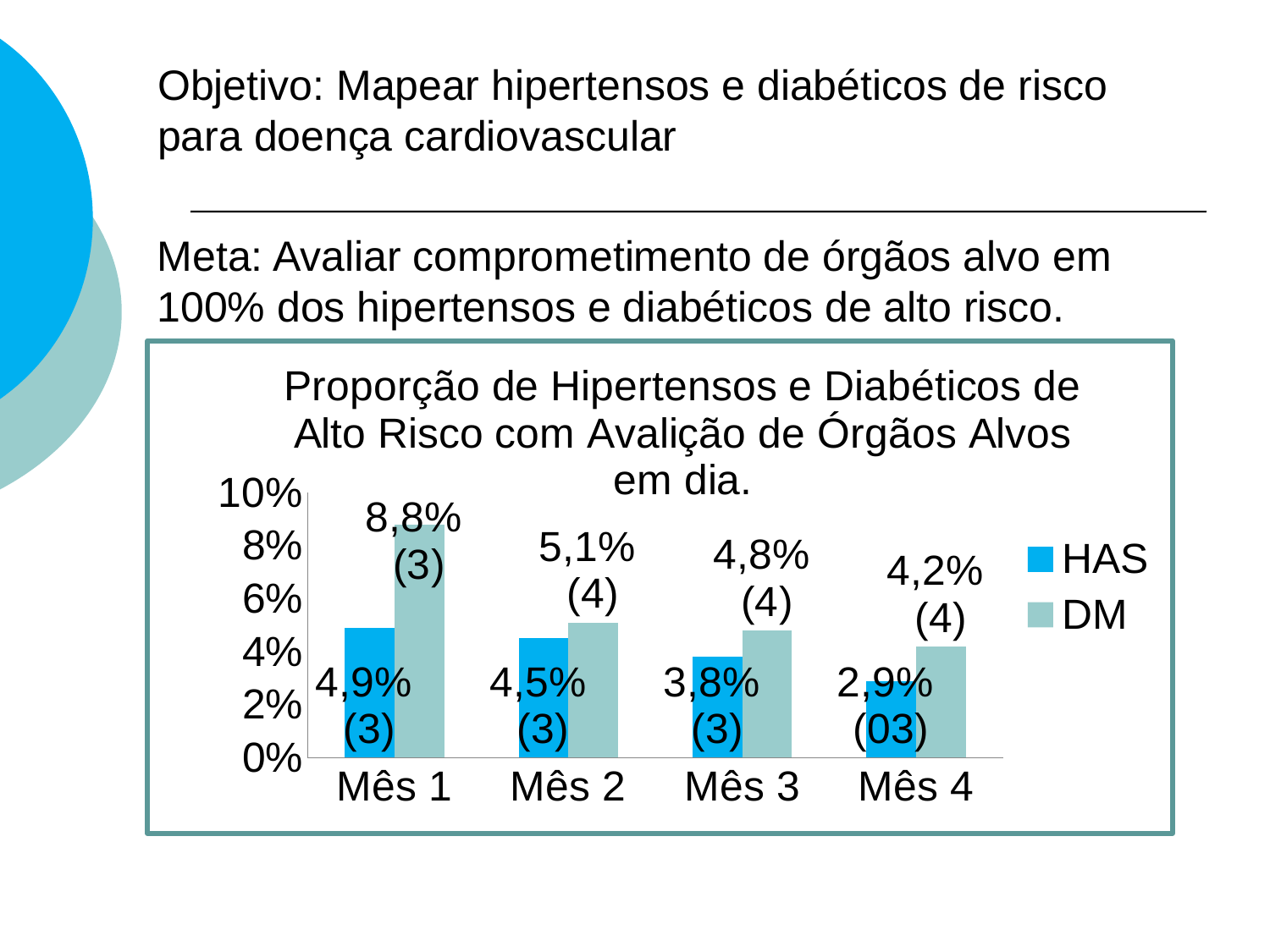
How many series does the legend list? 2 How many months are shown on the x axis? 4 Do the HAS values rise or fall from Mês 1 to Mês 4? Fall What is the HAS value for Mês 4? 2,9% What is the difference between the DM and HAS values in Mês 1? 3,9% What is the HAS value for Mês 1? 4,9% In which month is the HAS value lowest? Mês 4 What is the DM value for Mês 3? 4,8% In which month is the DM value highest? Mês 1 Which is larger in Mês 3, the HAS value or the DM value? DM What is the DM value for Mês 2? 5,1% What kind of chart is shown? Bar chart